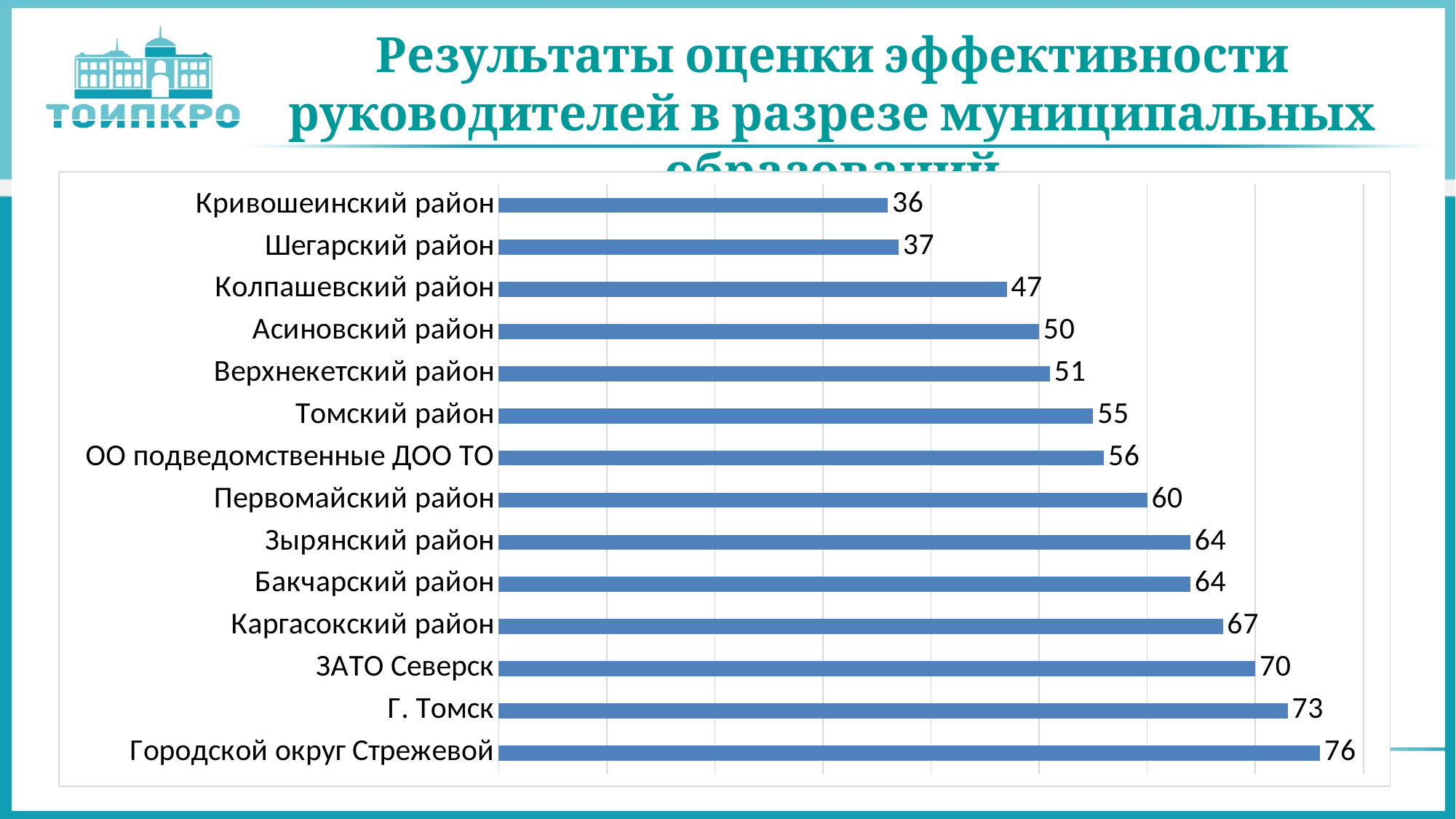
Which category has the lowest value? Кривошеинский район What is the difference between the values for Г. Томск and ЗАТО Северск? 3 Which two categories share the same value of 64? Зырянский район and Бакчарский район Which is larger, the value for Каргасокский район or the value for Первомайский район? Каргасокский район What is the value for ОО подведомственные ДОО ТО? 56 How many categories are shown in the chart? 14 What is the value for Томский район? 55 What is the difference between the values for Городской округ Стрежевой and Кривошеинский район? 40 Which category has the highest value? Городской округ Стрежевой What is the value for Городской округ Стрежевой? 76 What kind of chart is shown on the slide? bar chart What is the value for Колпашевский район? 47